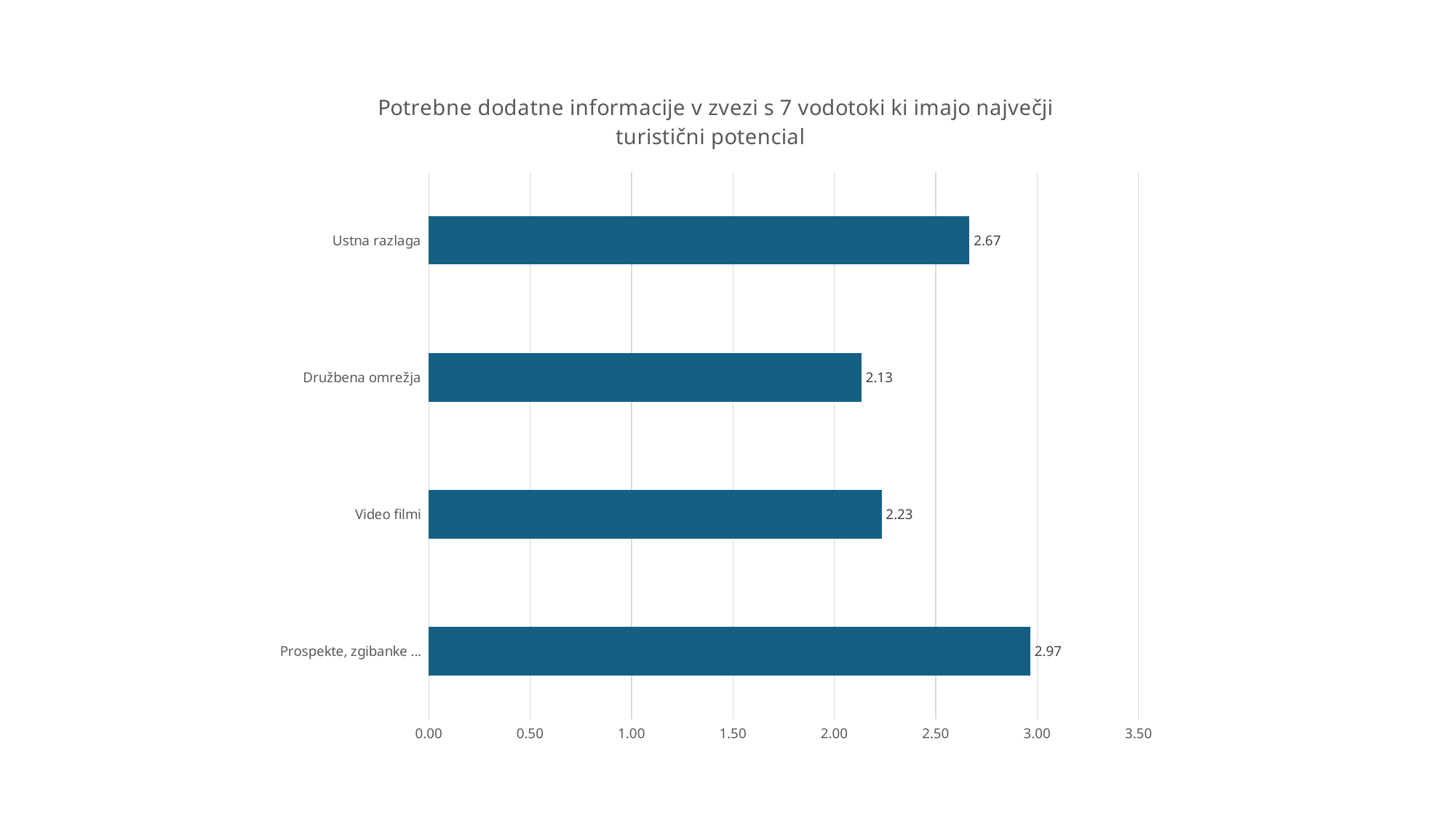
How many categories are shown in the chart? 4 What is the difference between the values for Prospekte, zgibanke ... and Ustna razlaga? 0.30 What is the value for Prospekte, zgibanke ...? 2.97 Which category has the highest value? Prospekte, zgibanke ... What is the difference between the values for Video filmi and Družbena omrežja? 0.10 Is the value for Družbena omrežja greater or less than 2.50? less Which is larger, the value for Ustna razlaga or the value for Video filmi? Ustna razlaga What kind of chart is shown on the slide? bar chart What is the value for Družbena omrežja? 2.13 Which category has the lowest value? Družbena omrežja What is the value for Ustna razlaga? 2.67 What is the value for Video filmi? 2.23